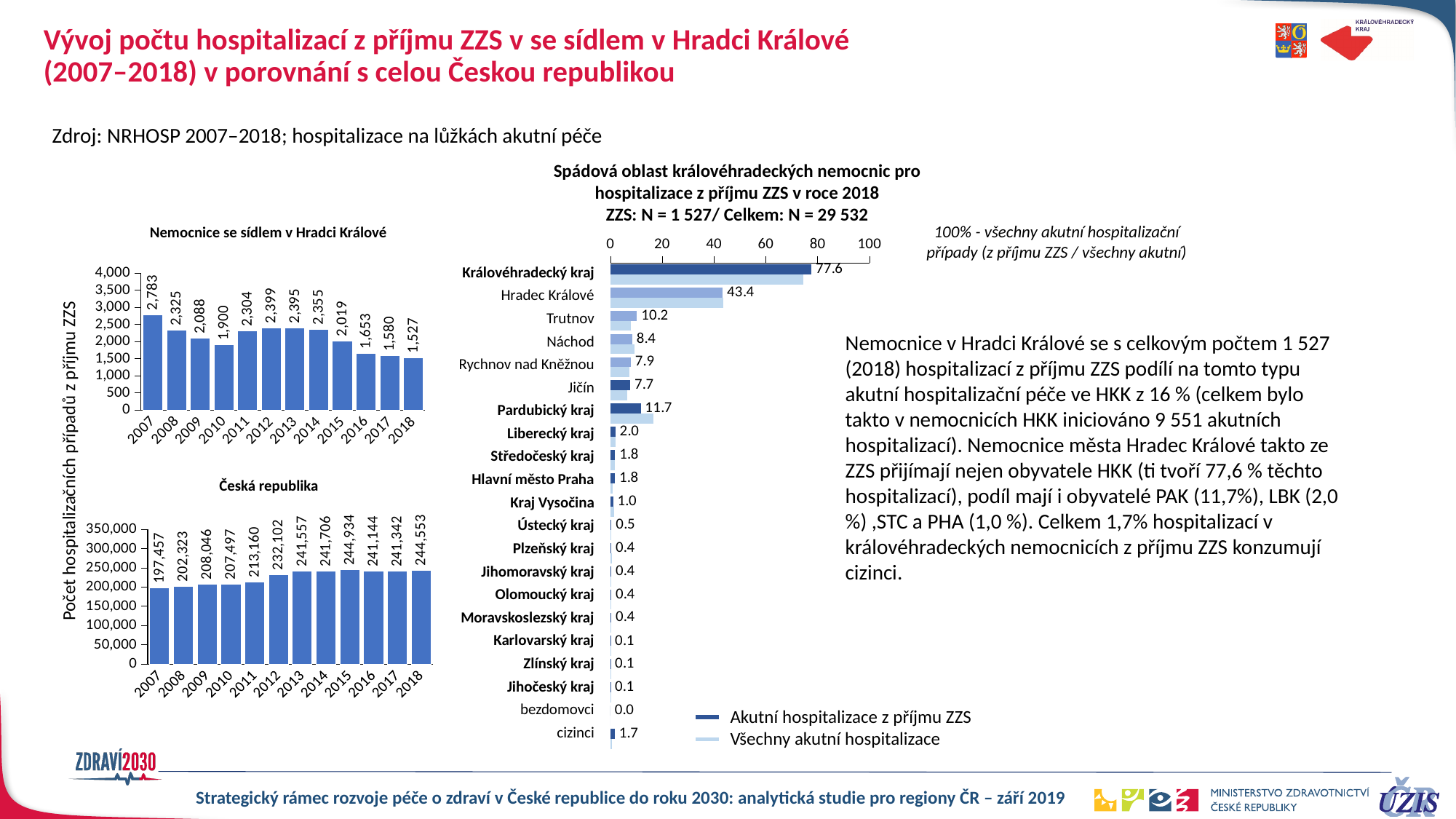
In the chart 'Spádová oblast královéhradeckých nemocnic pro hospitalizace z příjmu ZZS v roce 2018', what is the labelled value for Pardubický kraj? 11.7 How many years are shown in the chart 'Česká republika'? 12 How many series does the legend of the chart 'Spádová oblast královéhradeckých nemocnic pro hospitalizace z příjmu ZZS v roce 2018' list? 2 In the chart 'Spádová oblast královéhradeckých nemocnic pro hospitalizace z příjmu ZZS v roce 2018', which has the larger labelled value, Trutnov or Náchod? Trutnov In the chart 'Nemocnice se sídlem v Hradci Králové', what is the value for 2018? 1,527 In the chart 'Česká republika', what is the value for 2015? 244,934 What kind of chart is 'Spádová oblast královéhradeckých nemocnic pro hospitalizace z příjmu ZZS v roce 2018'? bar chart In the chart 'Nemocnice se sídlem v Hradci Králové', which year has the lowest value? 2018 In the chart 'Nemocnice se sídlem v Hradci Králové', which year has the highest value? 2007 In the chart 'Česká republika', which year has the lowest value? 2007 In the chart 'Česká republika', which year has the highest value? 2015 In the chart 'Nemocnice se sídlem v Hradci Králové', what is the difference between the values for 2007 and 2018? 1,256